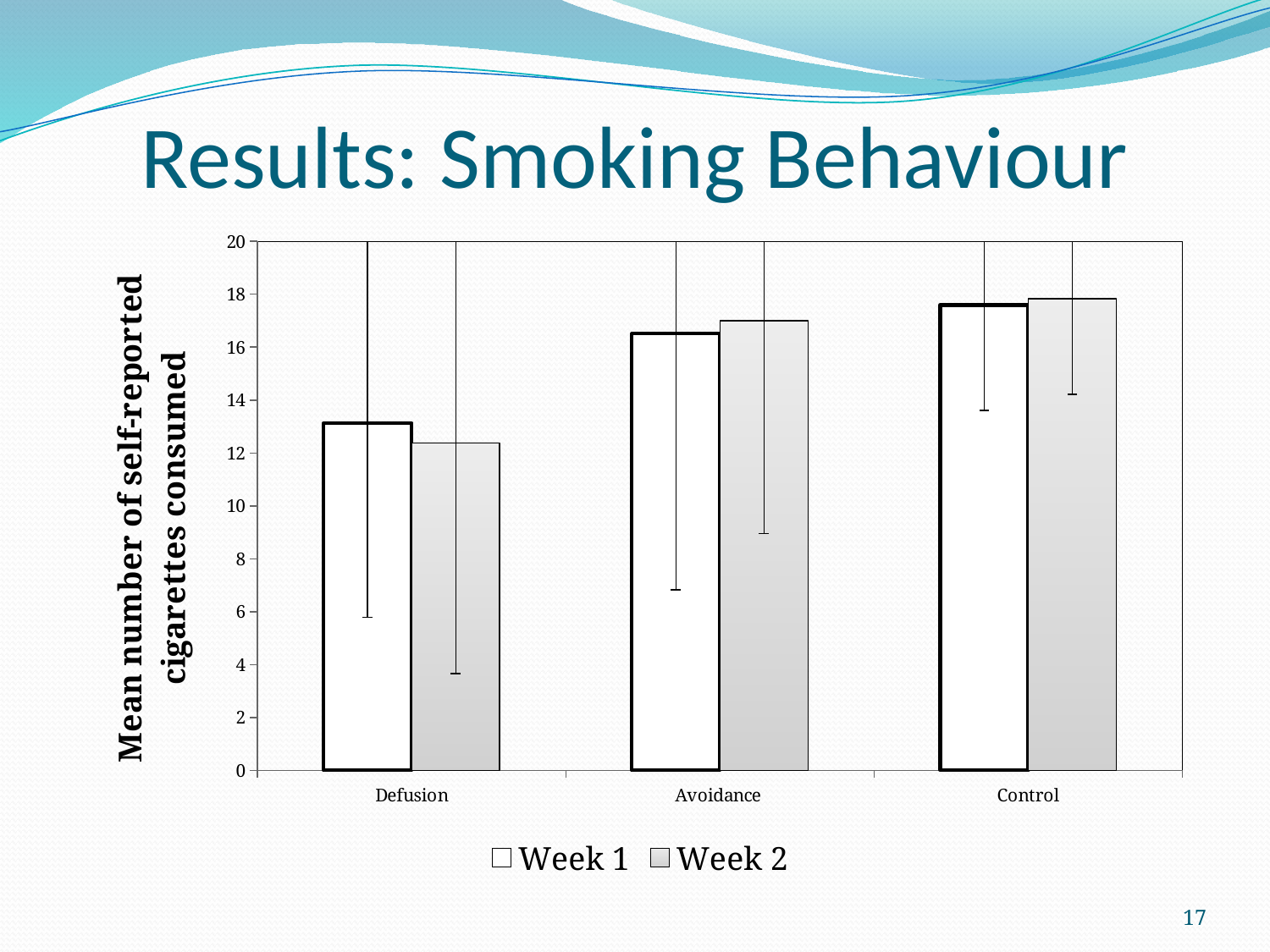
What kind of chart is shown on the slide? bar chart Is the Week 2 value for Avoidance greater or less than 16? greater Which category has the lowest Week 2 value? Defusion How many categories are shown on the x axis of the chart? 3 Is the Week 2 value for Defusion greater or less than 14? less Which category has the lowest Week 1 value? Defusion Which category has the highest Week 1 value? Control Is the Week 1 value for Defusion greater or less than 12? greater Which is larger, the Week 1 value for Defusion or the Week 1 value for Avoidance? Avoidance How many series does the legend list? 2 What is the label of the y axis of the chart? Mean number of self-reported cigarettes consumed